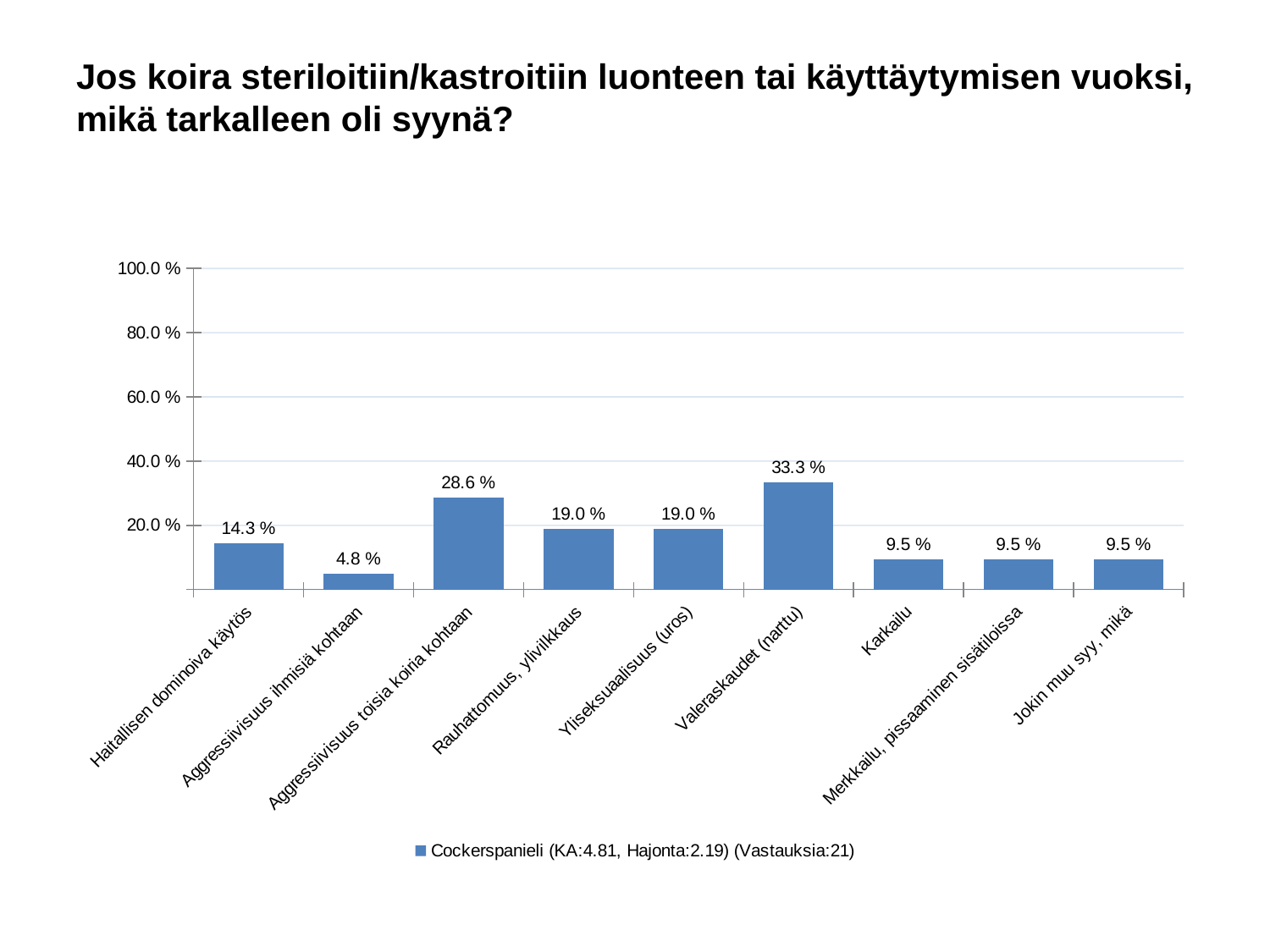
What is the value for Haitallisen dominoiva käytös? 14.3 % Which category has the highest value? Valeraskaudet (narttu) How many categories are shown on the x axis? 9 What is the value for Valeraskaudet (narttu)? 33.3 % What is the difference between the values for Aggressiivisuus toisia koiria kohtaan and Haitallisen dominoiva käytös? 14.3 % What is the legend entry for the series? Cockerspanieli (KA:4.81, Hajonta:2.19) (Vastauksia:21) What kind of chart is shown on the slide? bar chart Which is larger, the value for Rauhattomuus, ylivilkkaus or the value for Karkailu? Rauhattomuus, ylivilkkaus Is the value for Valeraskaudet (narttu) greater or less than 40.0 %? less What is the value for Aggressiivisuus ihmisiä kohtaan? 4.8 % How many series does the legend list? 1 Which category has the lowest value? Aggressiivisuus ihmisiä kohtaan